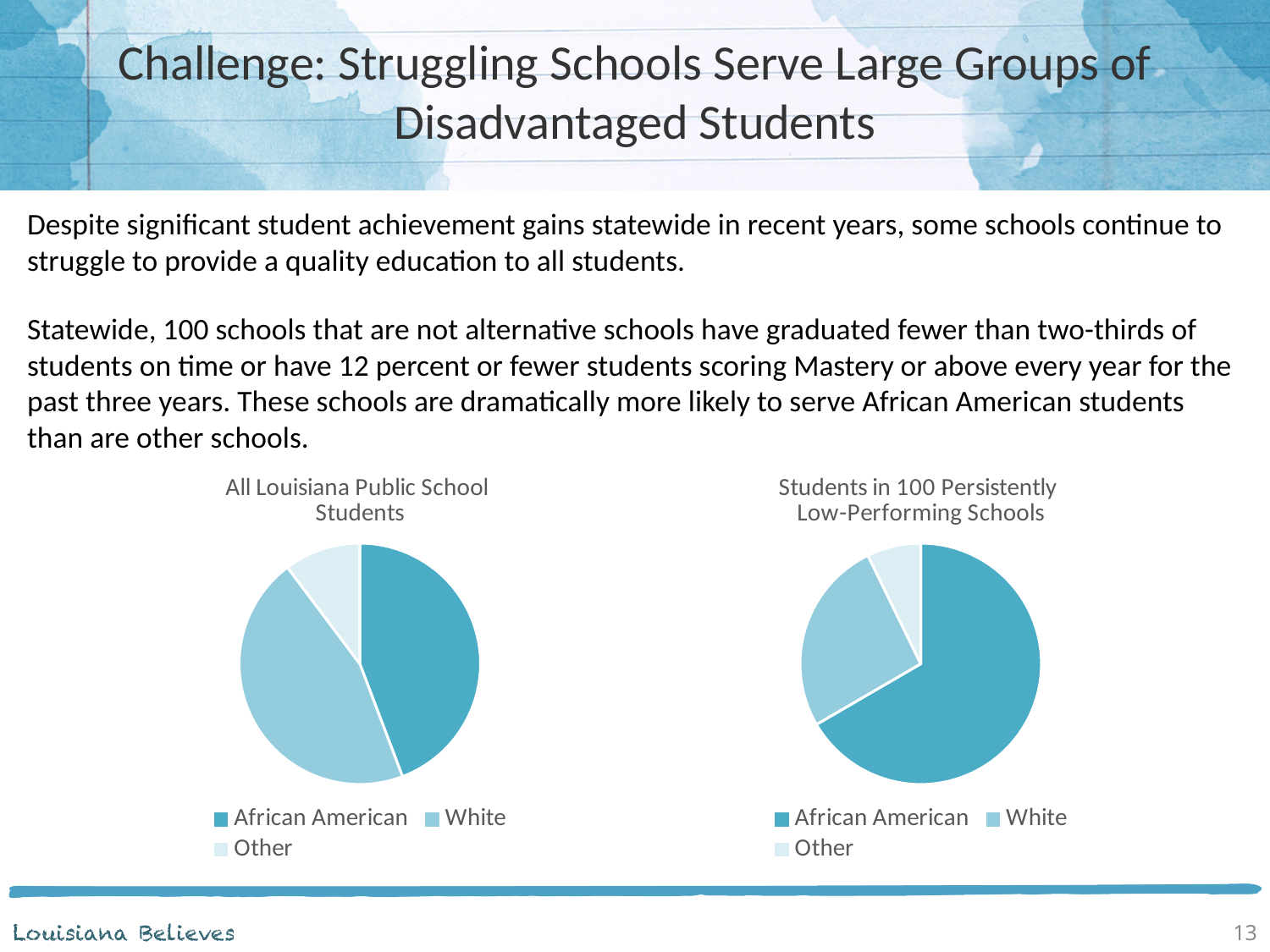
In the "Students in 100 Persistently Low-Performing Schools" chart, which group has the smallest slice? Other In the "Students in 100 Persistently Low-Performing Schools" chart, which slice is larger: White or Other? White In the "All Louisiana Public School Students" chart, which group has the smallest slice? Other What kind of chart is the "Students in 100 Persistently Low-Performing Schools" chart? pie chart What kind of chart is the "All Louisiana Public School Students" chart? pie chart What is the title of the pie chart on the right side of the slide? Students in 100 Persistently Low-Performing Schools In the "Students in 100 Persistently Low-Performing Schools" chart, which group has the largest slice? African American In the "Students in 100 Persistently Low-Performing Schools" chart, which slice is larger: African American or White? African American What are the legend entries of the "All Louisiana Public School Students" chart? African American, White, Other How many slices does the "All Louisiana Public School Students" pie chart have? 3 How many entries does the legend of the "Students in 100 Persistently Low-Performing Schools" chart list? 3 In the "All Louisiana Public School Students" chart, which slice is larger: White or Other? White